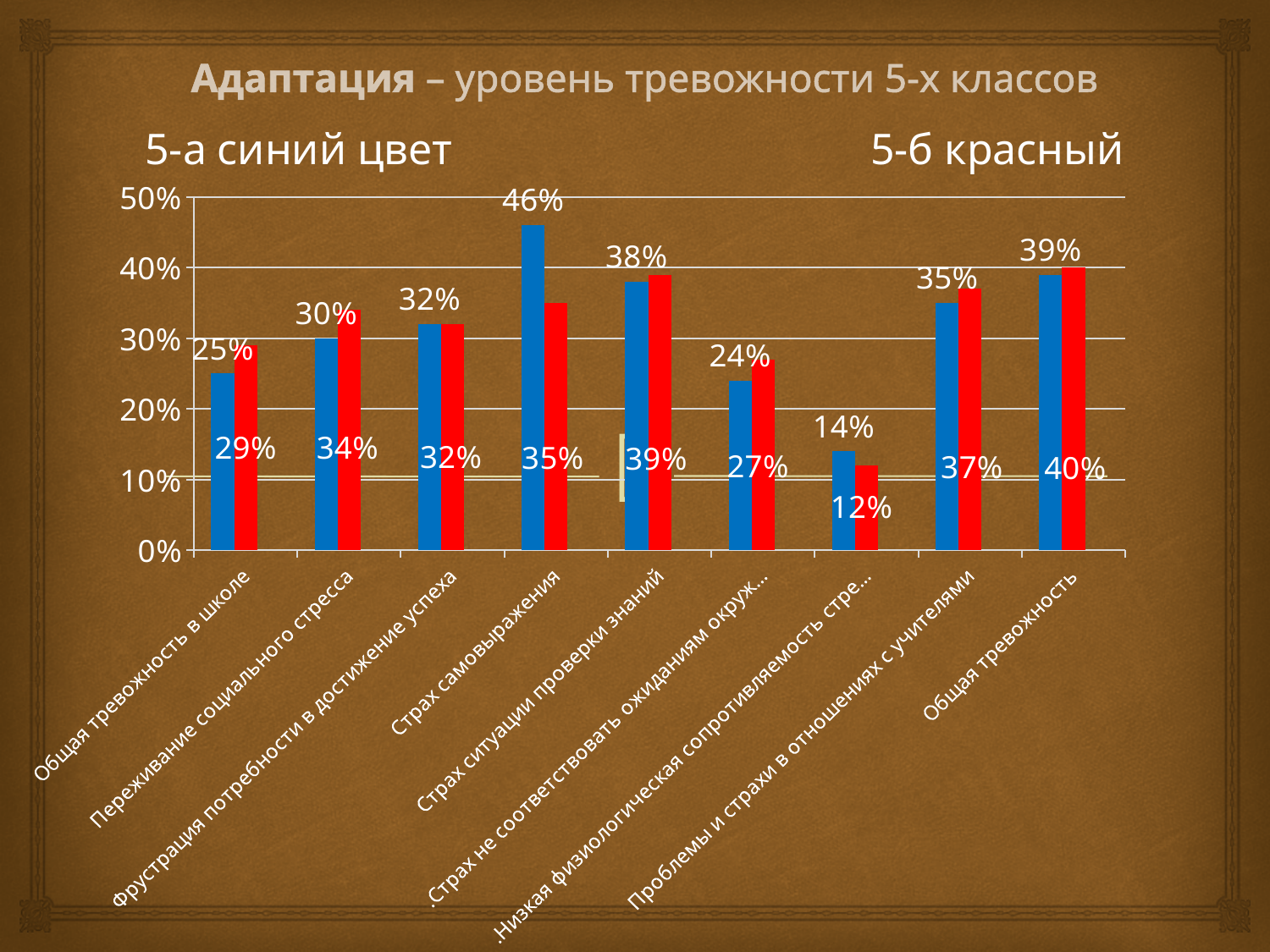
What is the value for class 5-б (red) for «Переживание социального стресса»? 34% Which category has the lowest value for class 5-б (red)? Низкая физиологическая сопротивляемость стре... What is the value for class 5-б (red) for «Общая тревожность»? 40% Is the 5-а (blue) value for «Проблемы и страхи в отношениях с учителями» greater or less than 30%? greater What is the title of the slide? Адаптация – уровень тревожности 5-х классов Which category has the highest value for class 5-а (blue)? Страх самовыражения How many categories are shown along the x axis of the chart? 9 What type of chart is shown on the slide? bar chart For «Общая тревожность в школе», which class has the larger value, 5-а (blue) or 5-б (red)? 5-б (red) What is the difference between the 5-а (blue) and 5-б (red) values for «Страх самовыражения»? 11% Which colour represents class 5-а on the chart? синий (blue) What is the value for class 5-а (blue) for «Страх самовыражения»? 46%